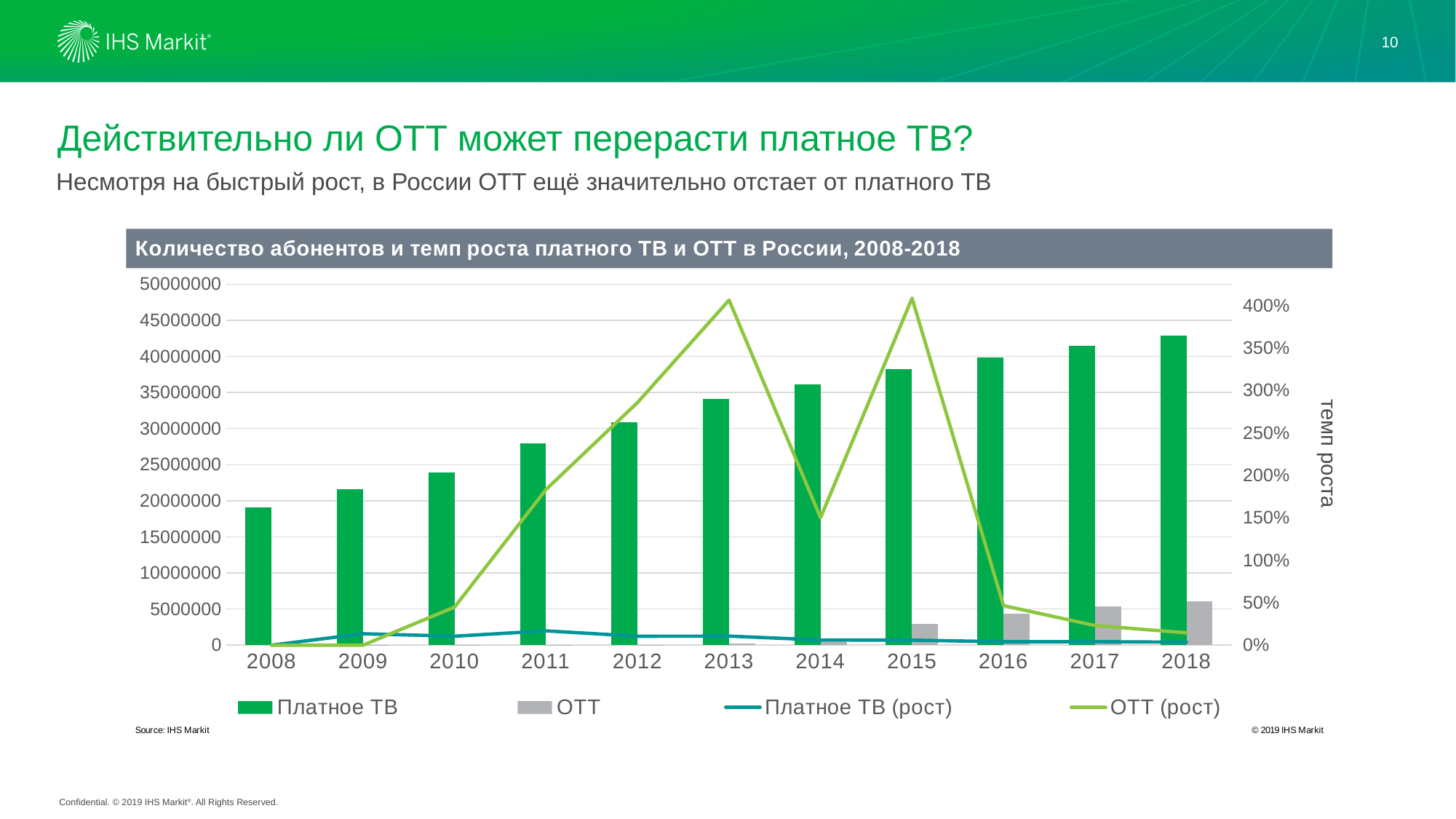
What is the title of the chart? Количество абонентов и темп роста платного ТВ и ОТТ в России, 2008-2018 Is the OTT (рост) value for 2013 greater or less than 350%? greater Do the Платное ТВ bars rise or fall from 2008 to 2018? Rise How many years are shown on the x axis of the chart? 11 Is the Платное ТВ value for 2018 greater or less than 40000000? greater In which year is the Платное ТВ bar the highest? 2018 Is the Платное ТВ value for 2008 greater or less than 20000000? less In which year is the Платное ТВ bar the lowest? 2008 How many series does the chart legend list? 4 Which is larger, the OTT bar for 2016 or for 2017? 2017 What kind of chart is shown on the slide? A combined bar and line chart